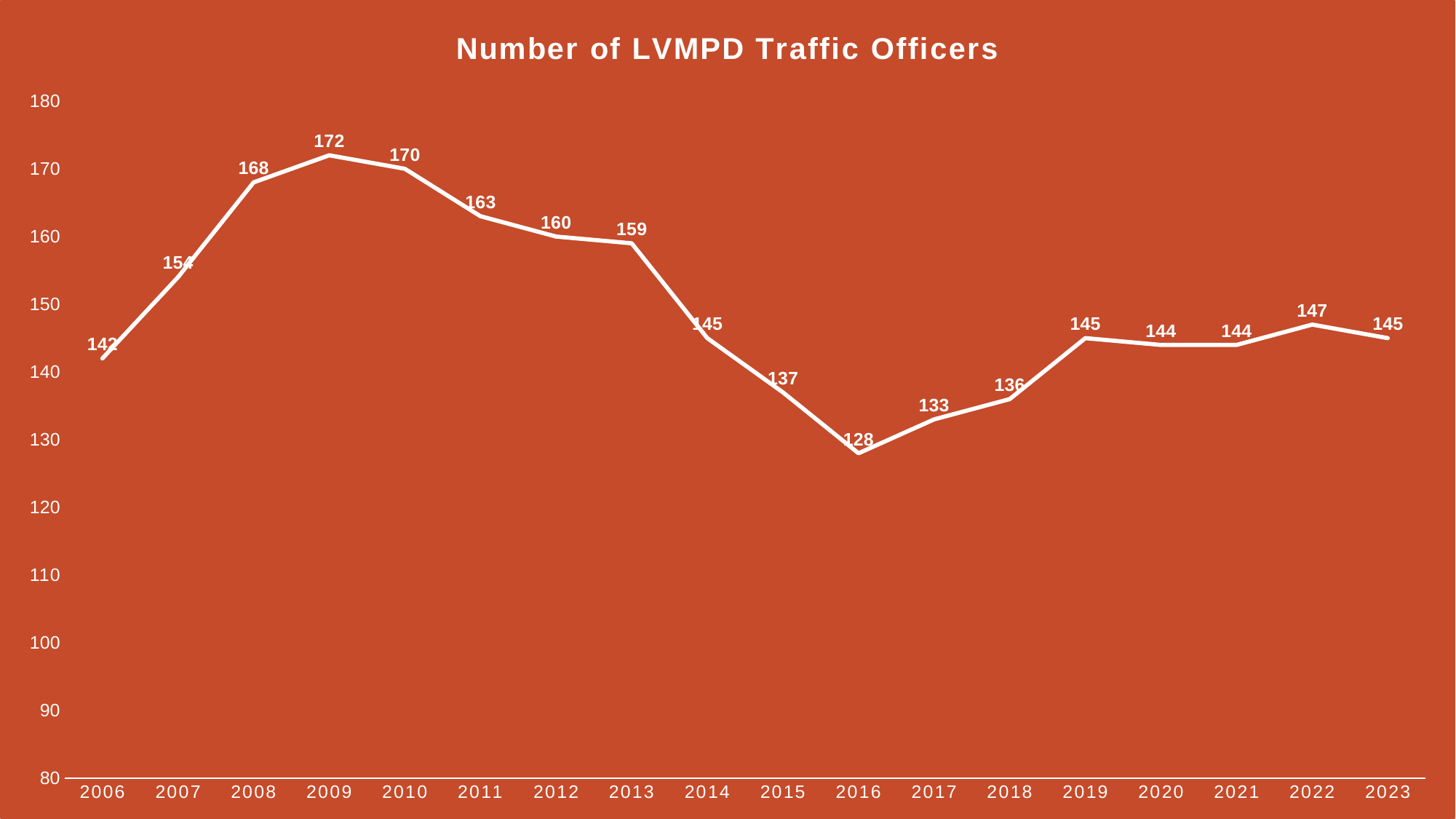
How many years are plotted on the chart? 18 What is the difference between the number of traffic officers in 2009 and in 2016? 44 Which year has the lowest number of LVMPD traffic officers? 2016 Which year has the highest number of LVMPD traffic officers? 2009 Does the number of traffic officers rise or fall from 2009 to 2016? fall What is the number of LVMPD traffic officers in 2016? 128 What is the difference between the number of traffic officers in 2006 and in 2008? 26 What is the number of LVMPD traffic officers in 2023? 145 What is the number of LVMPD traffic officers in 2009? 172 Which year had more traffic officers, 2013 or 2019? 2013 What kind of chart is shown on the slide? line chart Is the number of traffic officers in 2015 greater or less than 140? less